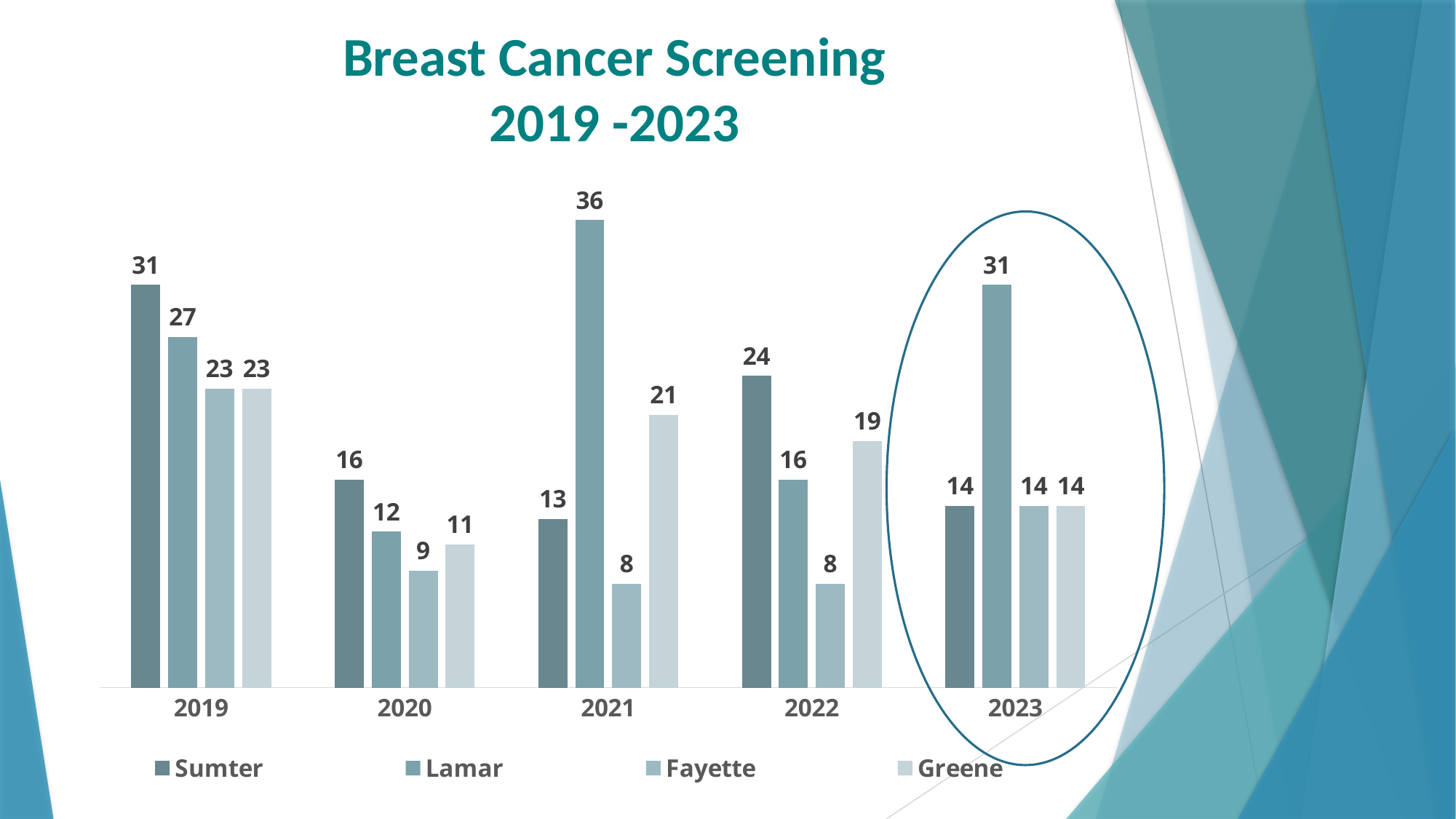
Which year has the lowest value for Sumter? 2021 What is the value for Greene in 2022? 19 What is the value for Lamar in 2021? 36 What is the value for Sumter in 2019? 31 What is the difference between Lamar and Sumter in 2023? 17 Which is larger in 2022, Sumter or Lamar? Sumter Which year has the highest value for Lamar? 2021 What is the value for Fayette in 2020? 9 What kind of chart is shown on the slide? Bar chart What is the title of the chart? Breast Cancer Screening 2019 -2023 How many years are shown on the x axis? 5 How many series does the legend list? 4